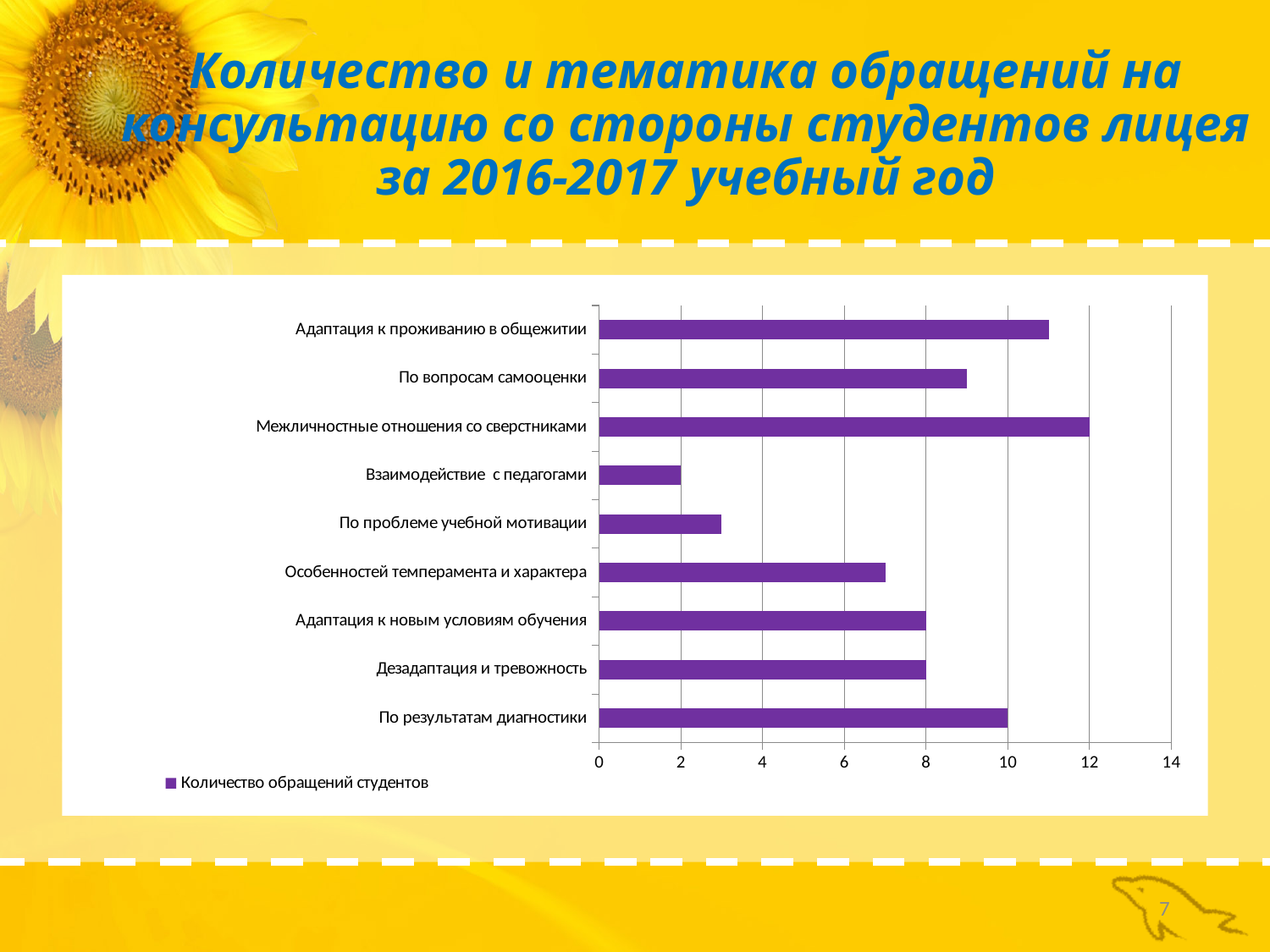
How many series does the legend list? 1 Which category has the highest value? Межличностные отношения со сверстниками What kind of chart is shown on the slide? bar chart What is the value for Межличностные отношения со сверстниками? 12 What is the difference between the values for Межличностные отношения со сверстниками and Взаимодействие с педагогами? 10 What is the value for Взаимодействие с педагогами? 2 Is the value for Адаптация к проживанию в общежитии greater or less than 10? greater What is the value for По результатам диагностики? 10 What is the legend entry for the series shown in the chart? Количество обращений студентов Which category has the lowest value? Взаимодействие с педагогами How many categories are plotted in the chart? 9 What is the value for Дезадаптация и тревожность? 8